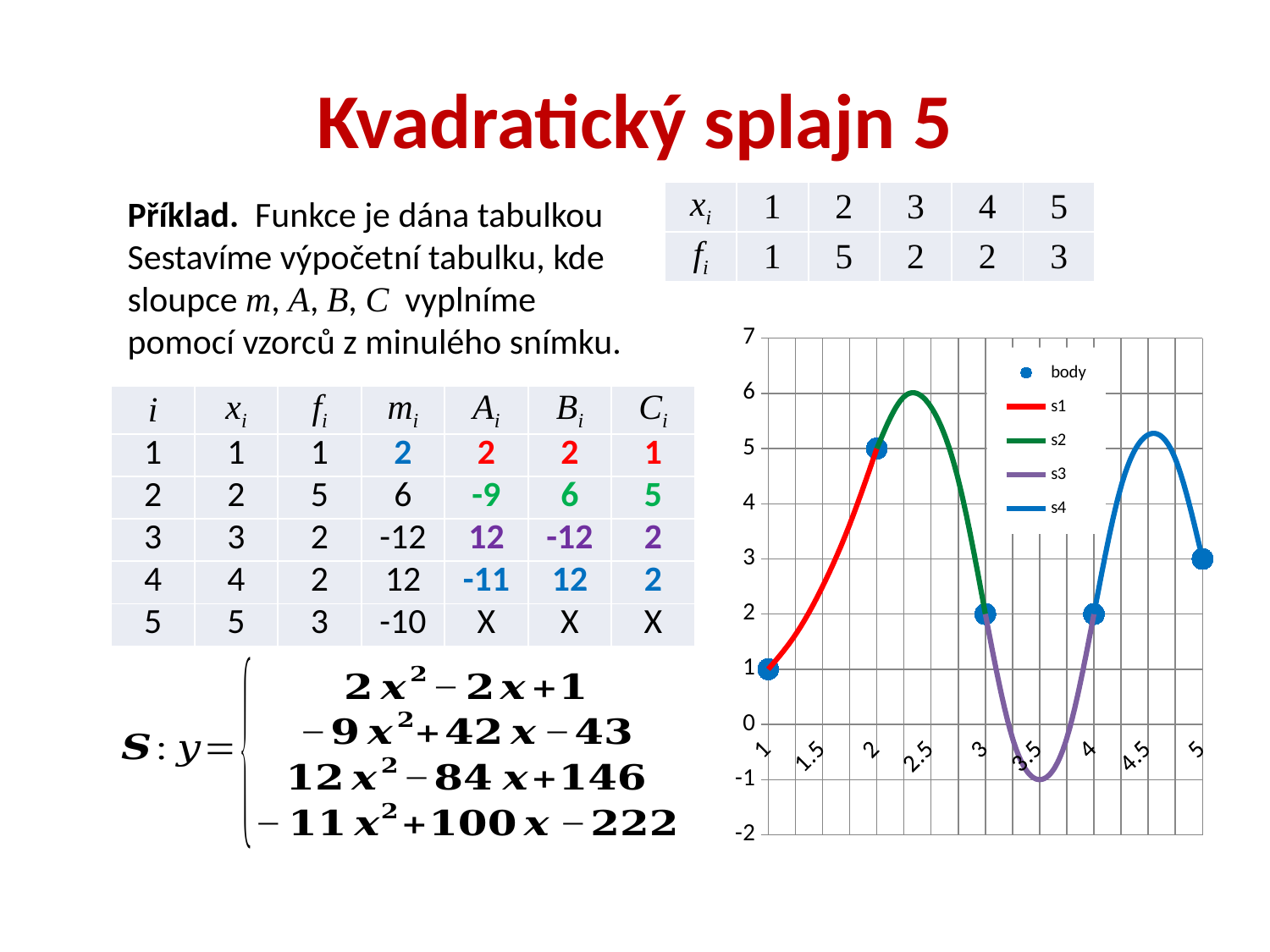
What is the y value of the plotted point at x = 1? 1 How many plotted points (body) are shown on the chart? 5 How many entries does the chart legend list? 5 What colour is the s1 curve? red What is the y value of the plotted point at x = 5? 3 At which x value does the highest plotted point occur? 2 Which plotted point has the larger y value, the one at x = 2 or the one at x = 5? x = 2 What is the difference between the y values of the points at x = 2 and x = 1? 4 At which x value does the lowest plotted point occur? 1 Is the lowest value reached by the s3 curve greater or less than 0? less What is the y value of the plotted point at x = 2? 5 Is the peak of the s2 curve greater or less than 5? greater